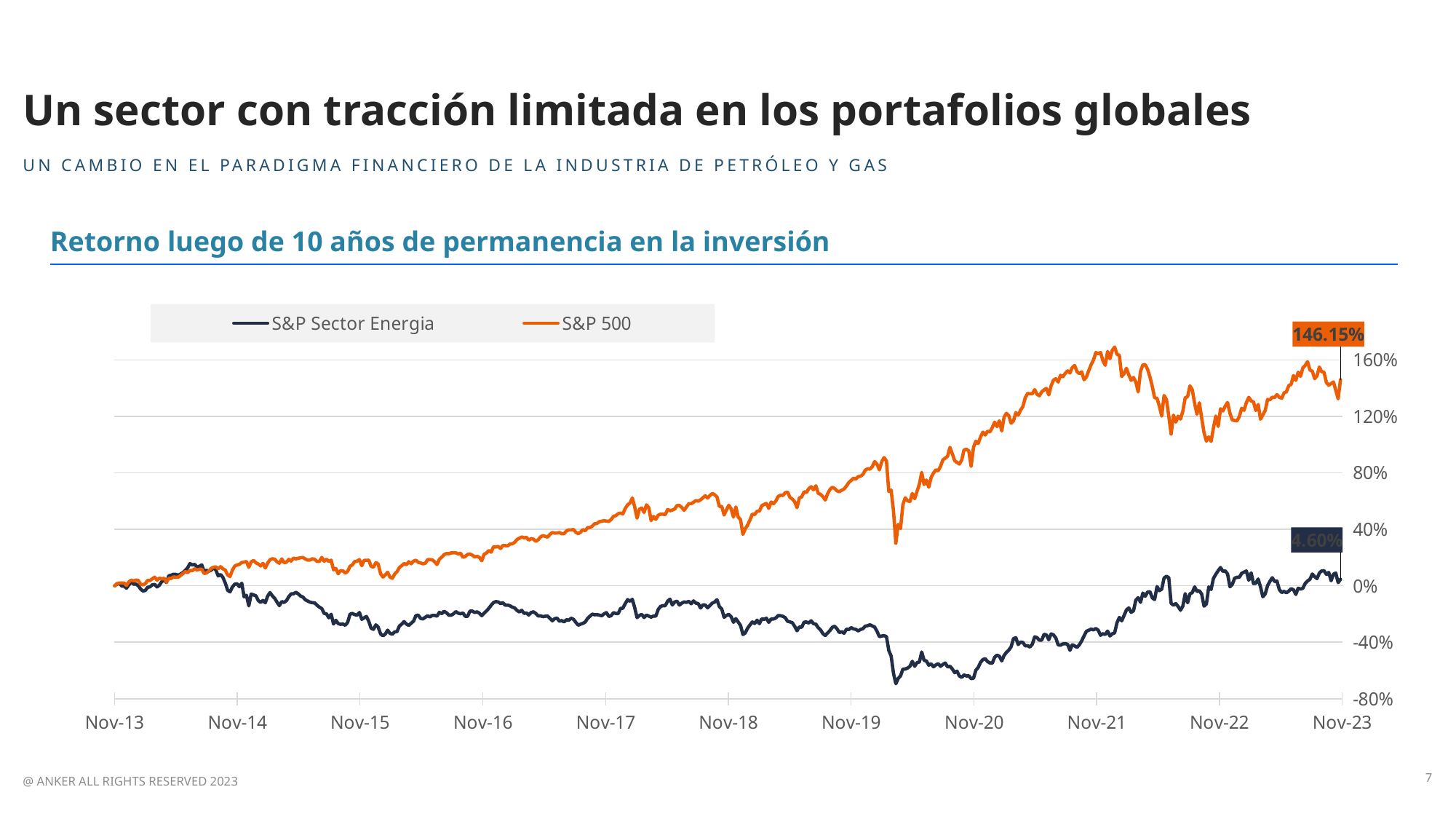
What kind of chart is shown on the slide? Line chart Does the S&P 500 series generally rise or fall from Nov-13 to Nov-23? Rise How many date labels are shown on the x axis? 11 Which series ends higher at Nov-23, S&P 500 or S&P Sector Energia? S&P 500 Is the value of the S&P Sector Energia series around Nov-20 greater or less than -40%? less How many series does the legend list? 2 Is the value of the S&P 500 series around Nov-21 greater or less than 120%? greater What is the title of the chart? Retorno luego de 10 años de permanencia en la inversión What is the final value shown for the S&P 500 series at Nov-23? 146.15% Which series has the lower value at the end of the period (Nov-23)? S&P Sector Energia What is the difference between the final values of the S&P 500 and the S&P Sector Energia series? 141.55% What is the final value shown for the S&P Sector Energia series at Nov-23? 4.60%